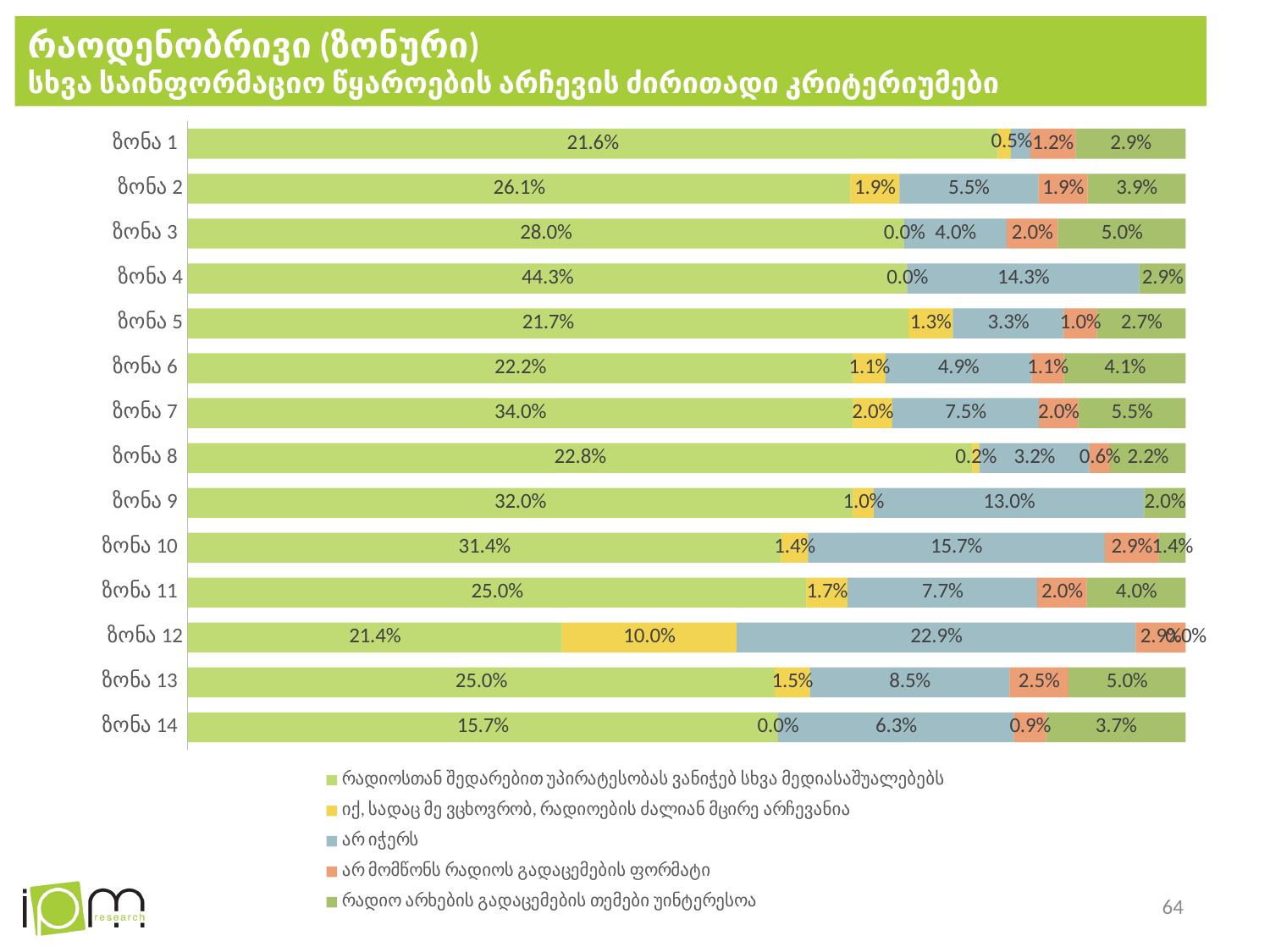
What type of chart is shown on the slide? Stacked bar chart How many series does the legend list? 5 What is the value of the 'არ მომწონს რადიოს გადაცემების ფორმატი' series for ზონა 13? 2.5% Which is larger: the first-series value for ზონა 7 or for ზონა 2? ზონა 7 How many zones (categories) are plotted in the chart? 14 Which zone has the highest value for the first series (რადიოსთან შედარებით უპირატესობას ვანიჭებ სხვა მედიასაშუალებებს)? ზონა 4 What is the value of the first series (რადიოსთან შედარებით უპირატესობას ვანიჭებ სხვა მედიასაშუალებებს) for ზონა 4? 44.3% What is the difference between the first-series values for ზონა 4 and ზონა 9? 12.3% What is the total of all segments in the bar for ზონა 7? 51.0% Which zone has the lowest value for the first series (რადიოსთან შედარებით უპირატესობას ვანიჭებ სხვა მედიასაშუალებებს)? ზონა 14 Which zone has the highest value for the 'იქ, სადაც მე ვცხოვრობ, რადიოების ძალიან მცირე არჩევანია' series? ზონა 12 What is the value of the 'არ იჭერს' series for ზონა 12? 22.9%